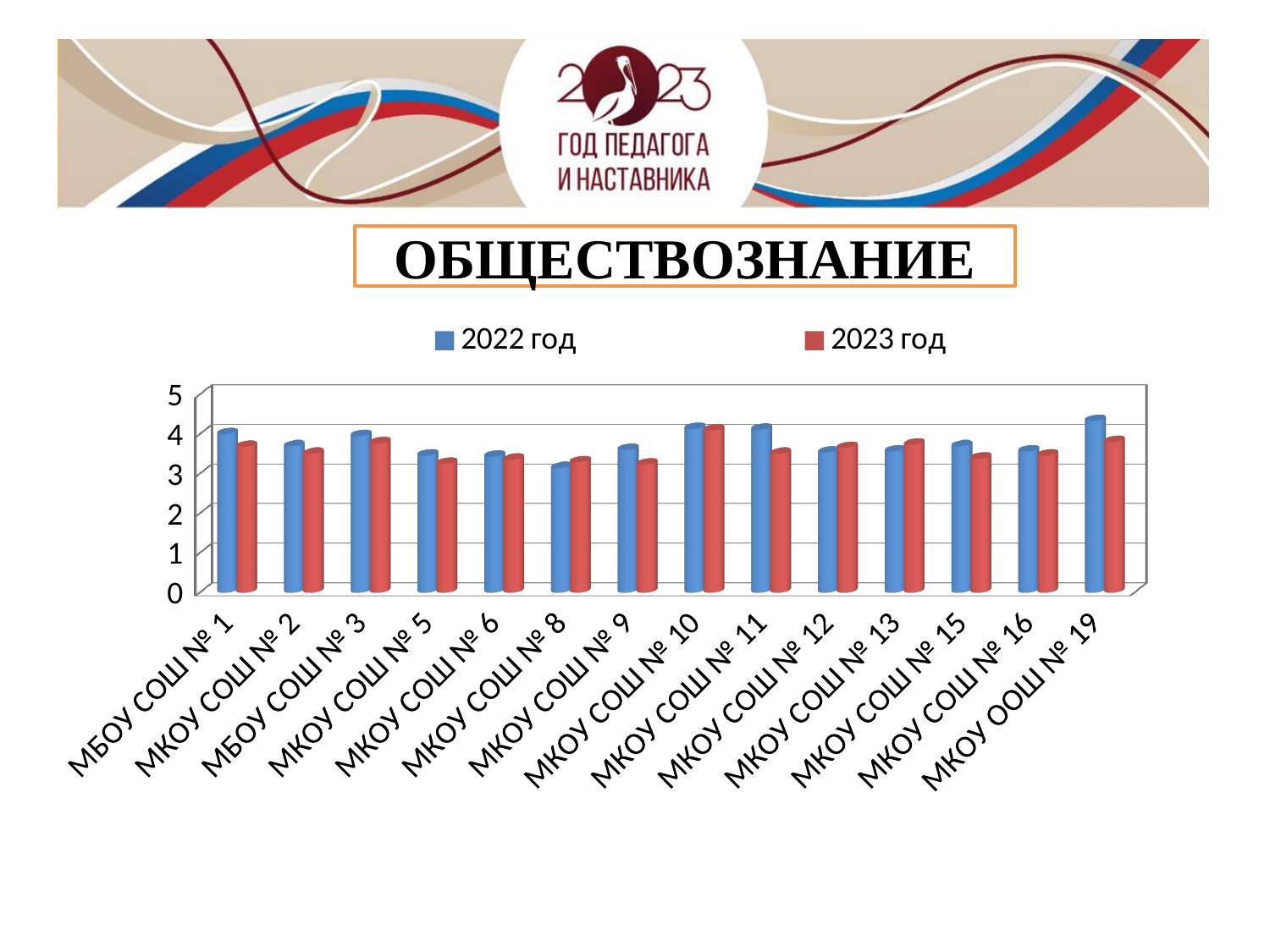
Which series is shown in red in the legend? 2023 год Is the 2023 год value for МКОУ СОШ № 11 greater or less than 4? less What is the title shown above the chart? ОБЩЕСТВОЗНАНИЕ Which school has the highest value for 2022 год? МКОУ ООШ № 19 For МКОУ СОШ № 11, which is larger: the 2022 год value or the 2023 год value? 2022 год For МКОУ СОШ № 9, which is larger: the 2022 год value or the 2023 год value? 2022 год Which school has the highest value for 2023 год? МКОУ СОШ № 10 Which school has the lowest value for 2022 год? МКОУ СОШ № 8 How many series does the legend list? 2 How many schools (categories) are shown on the x axis? 14 Is the 2022 год value for МКОУ ООШ № 19 greater or less than 4? greater What kind of chart is shown on the slide? bar chart